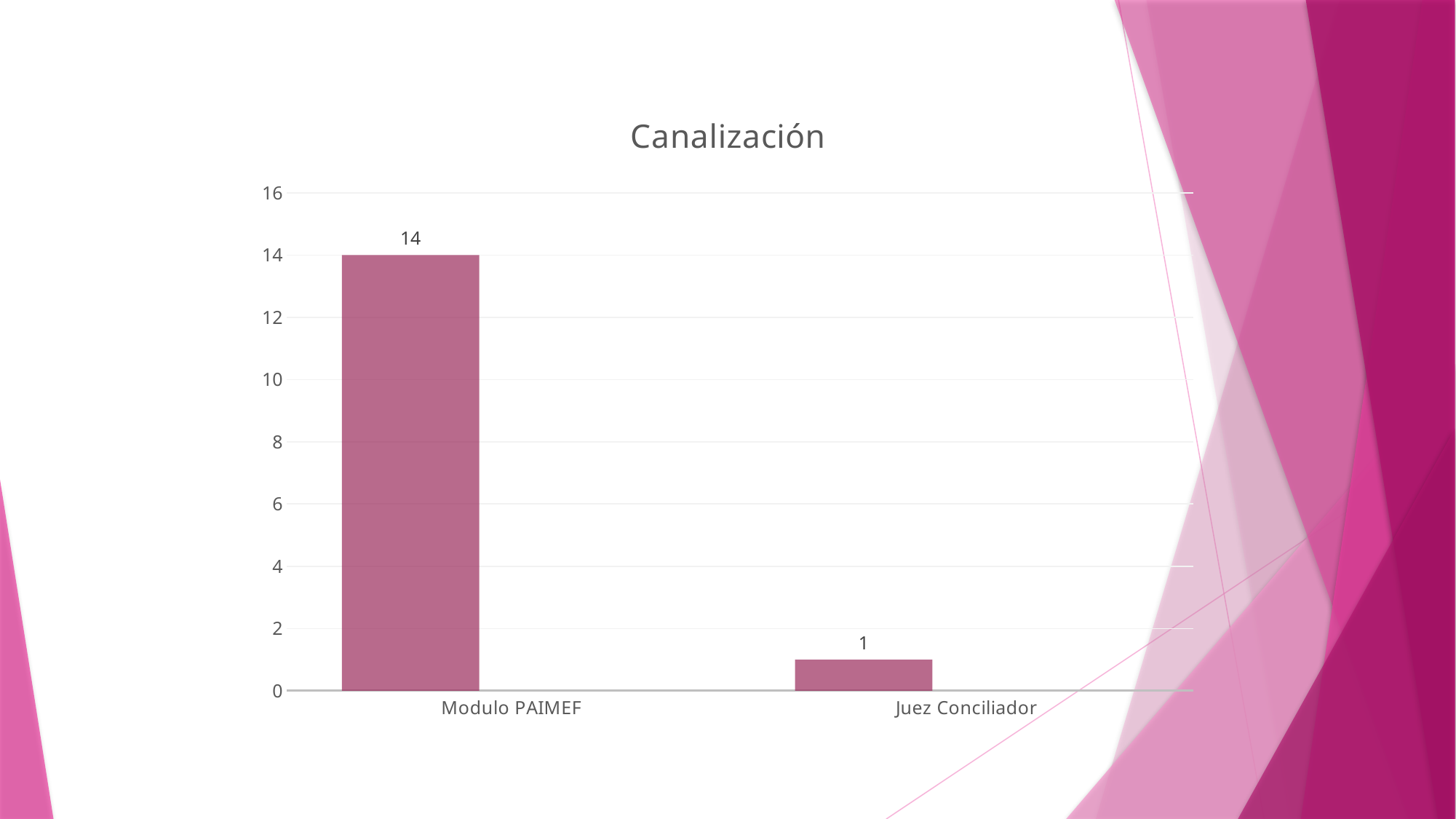
What is the value for Juez Conciliador? 1 Which category has the lowest value? Juez Conciliador Which is larger, the value for Modulo PAIMEF or the value for Juez Conciliador? Modulo PAIMEF Which category has the highest value? Modulo PAIMEF What kind of chart is shown on the slide? bar chart Is the value for Modulo PAIMEF greater or less than 10? greater Is the value for Juez Conciliador greater or less than 4? less How many categories are shown on the x axis? 2 What is the difference between the values for Modulo PAIMEF and Juez Conciliador? 13 What is the title of the chart? Canalización What is the value for Modulo PAIMEF? 14 What is the highest value shown on the vertical axis? 16